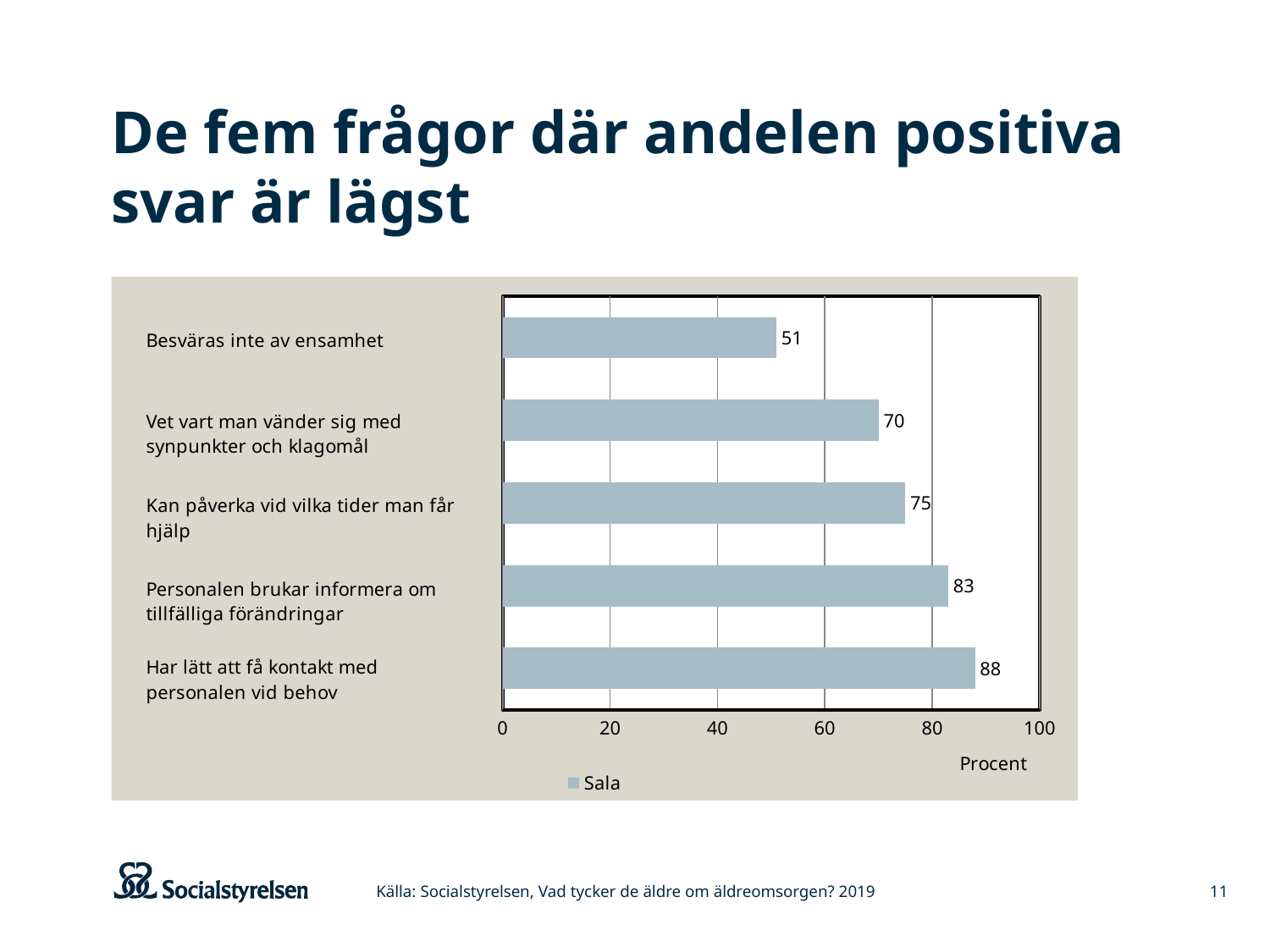
What kind of chart is shown on the slide? bar chart Is the value for "Personalen brukar informera om tillfälliga förändringar" greater or less than 80? greater How many series does the legend list? 1 What is the value for "Kan påverka vid vilka tider man får hjälp"? 75 Which category has the lowest value? Besväras inte av ensamhet Which category has the highest value? Har lätt att få kontakt med personalen vid behov How many categories are shown in the chart? 5 What is the value for "Har lätt att få kontakt med personalen vid behov"? 88 Which is larger: the value for "Kan påverka vid vilka tider man får hjälp" or the value for "Vet vart man vänder sig med synpunkter och klagomål"? Kan påverka vid vilka tider man får hjälp What is the value for "Besväras inte av ensamhet"? 51 What is the difference between the values for "Personalen brukar informera om tillfälliga förändringar" and "Vet vart man vänder sig med synpunkter och klagomål"? 13 What is the difference between the values for "Har lätt att få kontakt med personalen vid behov" and "Besväras inte av ensamhet"? 37